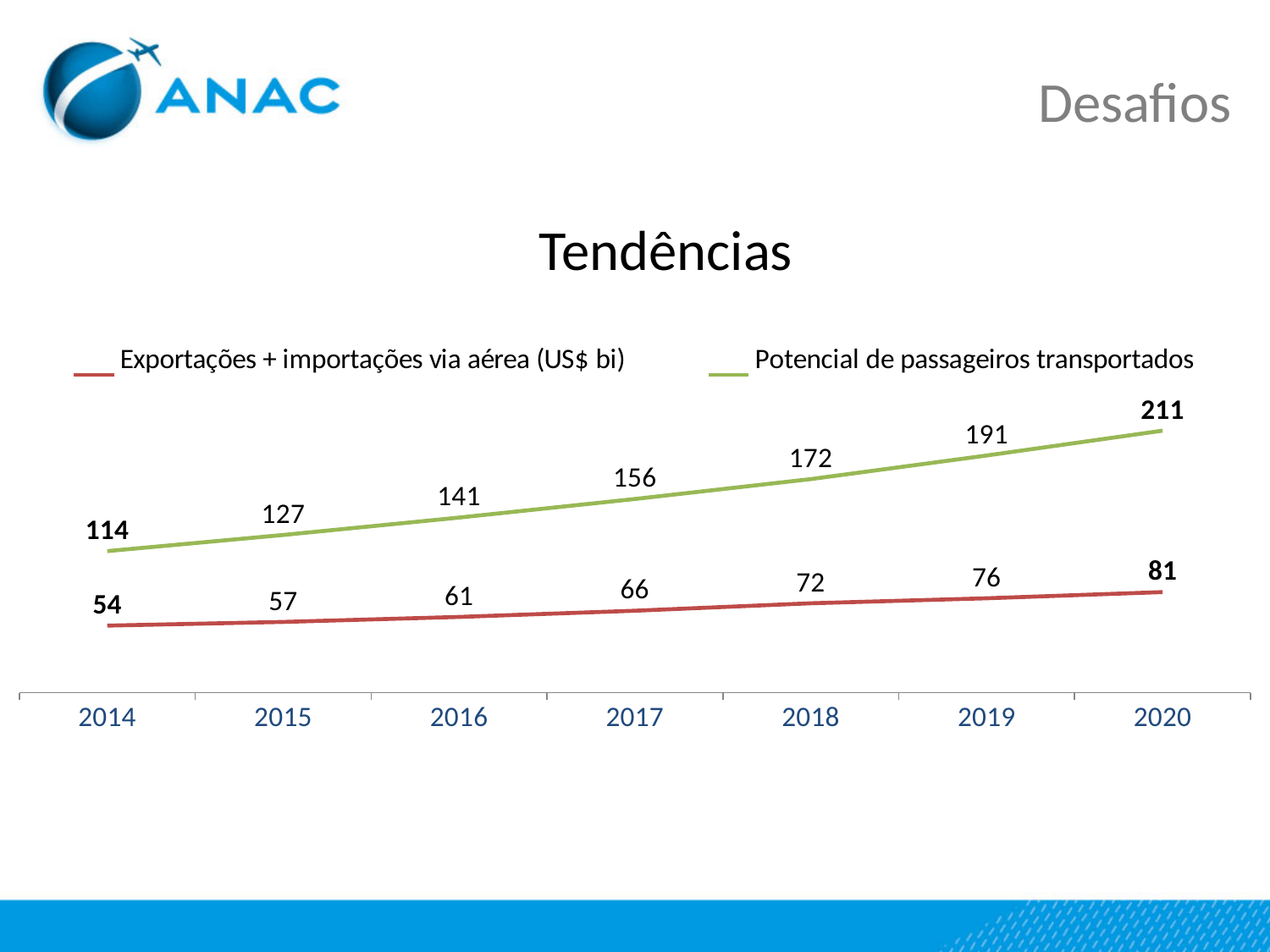
In which year is 'Potencial de passageiros transportados' highest? 2020 What is the difference between the 2020 and 2014 values of 'Potencial de passageiros transportados'? 97 Which series has the larger value in 2019, 'Exportações + importações via aérea (US$ bi)' or 'Potencial de passageiros transportados'? Potencial de passageiros transportados What is the value of 'Exportações + importações via aérea (US$ bi)' in 2018? 72 What is the difference between the 2020 and 2014 values of 'Exportações + importações via aérea (US$ bi)'? 27 How many years are shown on the x axis? 7 What is the value of 'Exportações + importações via aérea (US$ bi)' in 2014? 54 In which year is 'Exportações + importações via aérea (US$ bi)' lowest? 2014 How many series does the legend list? 2 What is the value of 'Potencial de passageiros transportados' in 2020? 211 What kind of chart is shown on the slide? Line chart What is the value of 'Potencial de passageiros transportados' in 2017? 156